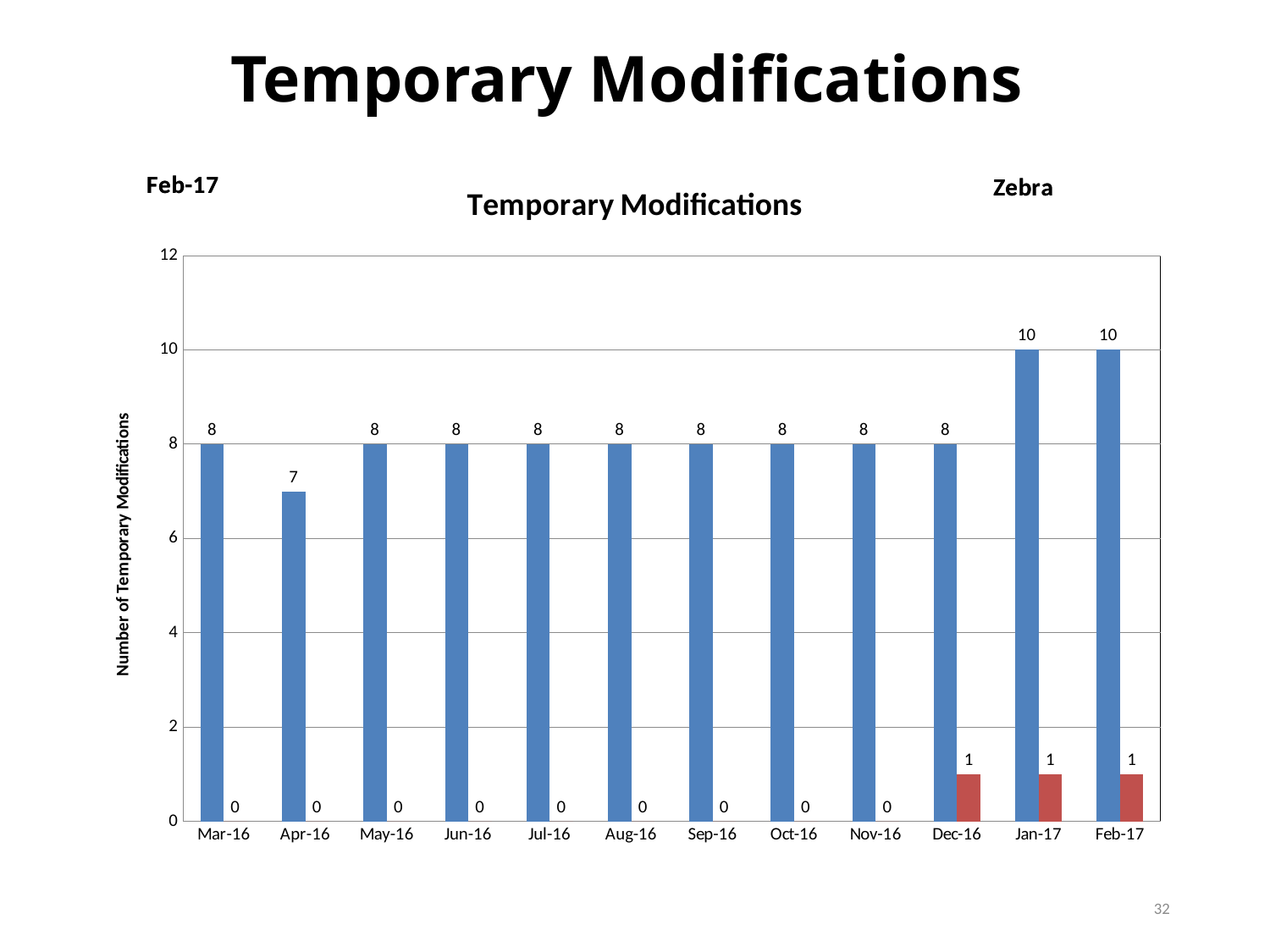
What is the label on the vertical axis of the chart? Number of Temporary Modifications What kind of chart is shown on the slide? Bar chart What is the value of the blue bar for Jan-17? 10 Which is larger, the blue bar for Dec-16 or the blue bar for Jan-17? Jan-17 Which month has the lowest blue bar? Apr-16 What is the title of the chart? Temporary Modifications Do the blue bar values rise or fall from Dec-16 to Jan-17? Rise What is the value of the blue bar for Apr-16? 7 What is the value of the red bar for Dec-16? 1 What is the value of the red bar for Aug-16? 0 How many months are shown on the x axis? 12 What is the difference between the blue bar for Feb-17 and the blue bar for Apr-16? 3